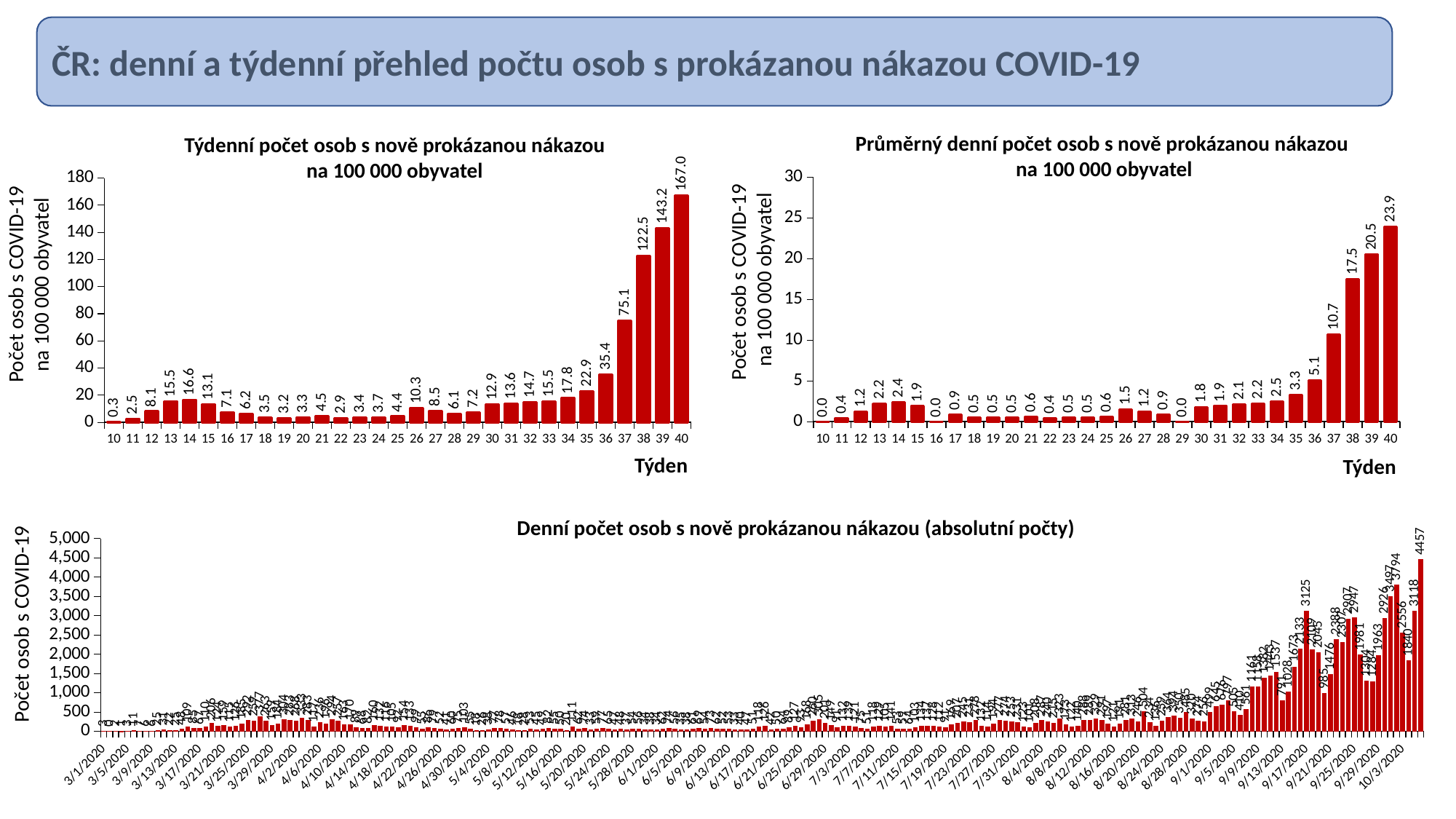
In the chart 'Týdenní počet osob s nově prokázanou nákazou na 100 000 obyvatel', what is the difference between the values for week 40 and week 39? 23.8 In the chart 'Průměrný denní počet osob s nově prokázanou nákazou na 100 000 obyvatel', what is the difference between the values for week 40 and week 37? 13.2 In the chart 'Týdenní počet osob s nově prokázanou nákazou na 100 000 obyvatel', which week has the lowest value? 10 What type of chart is 'Denní počet osob s nově prokázanou nákazou (absolutní počty)'? bar chart In the chart 'Denní počet osob s nově prokázanou nákazou (absolutní počty)', what is the value of the last (rightmost) bar? 4457 In the chart 'Týdenní počet osob s nově prokázanou nákazou na 100 000 obyvatel', how many weeks are shown on the x axis? 31 In the chart 'Průměrný denní počet osob s nově prokázanou nákazou na 100 000 obyvatel', which is larger: the value for week 14 or week 35? week 35 In the chart 'Průměrný denní počet osob s nově prokázanou nákazou na 100 000 obyvatel', which week has the highest value? 40 In the chart 'Průměrný denní počet osob s nově prokázanou nákazou na 100 000 obyvatel', what is the value for week 38? 17.5 In the chart 'Týdenní počet osob s nově prokázanou nákazou na 100 000 obyvatel', what is the value for week 37? 75.1 In the chart 'Průměrný denní počet osob s nově prokázanou nákazou na 100 000 obyvatel', is the value for week 39 greater or less than 20? greater In the chart 'Týdenní počet osob s nově prokázanou nákazou na 100 000 obyvatel', what is the value for week 40? 167.0